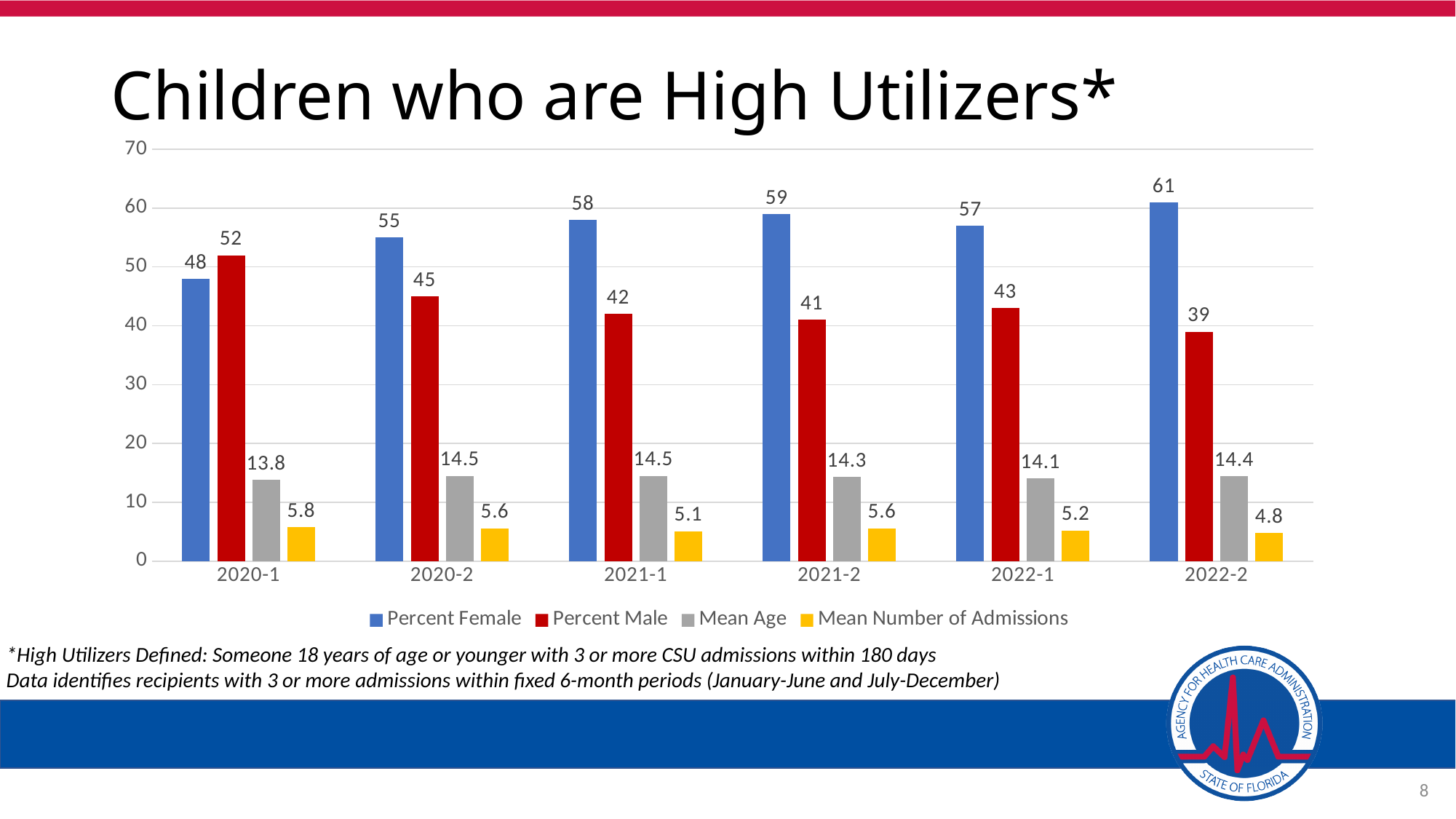
What is the Percent Male value for 2022-1? 43 What is the Mean Number of Admissions for 2022-2? 4.8 What is the Percent Female value for 2021-2? 59 What kind of chart is shown on the slide? Bar chart What is the Mean Age for 2020-1? 13.8 What colour are the Mean Age bars? Gray How many series does the legend list? 4 What is the difference between Percent Female and Percent Male in 2022-2? 22 How many periods are shown on the x axis? 6 In which period is Percent Male lowest? 2022-2 In which period is Percent Female highest? 2022-2 Which is larger in 2020-1, Percent Female or Percent Male? Percent Male